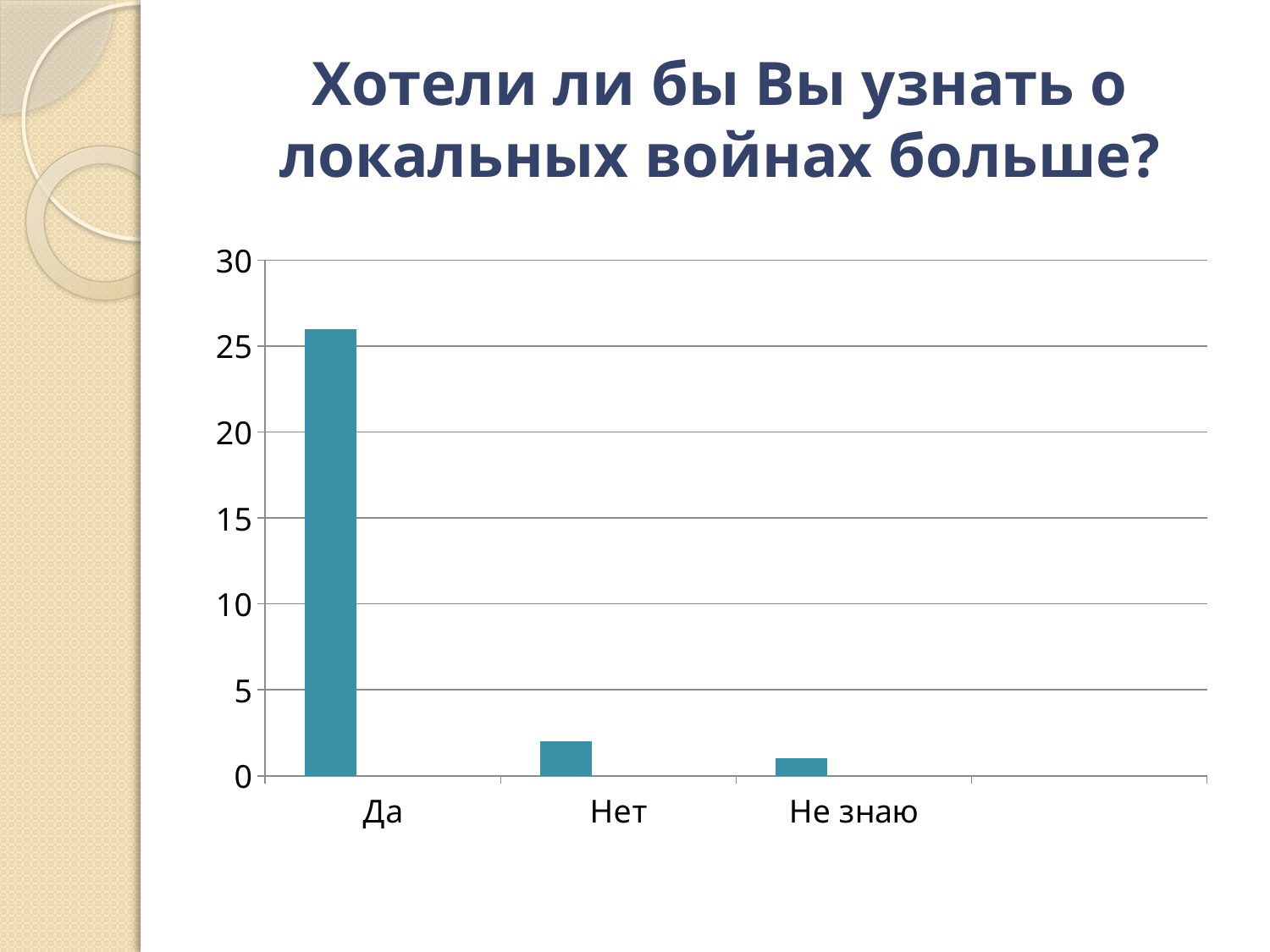
Is the value for Нет greater or less than 5? less Is the value for Да greater or less than 20? greater What is the title of the slide containing the chart? Хотели ли бы Вы узнать о локальных войнах больше? Which category has the lowest bar in the chart? Не знаю Which is larger, the value for Да or the value for Нет? Да Which is larger, the value for Нет or the value for Не знаю? Нет How many categories are shown on the x axis of the chart? 3 What is the highest value shown on the vertical axis of the chart? 30 Which category has the highest bar in the chart? Да Do the values rise or fall from left to right along the x axis? fall Is the value for Не знаю greater or less than 5? less What kind of chart is shown on the slide? bar chart